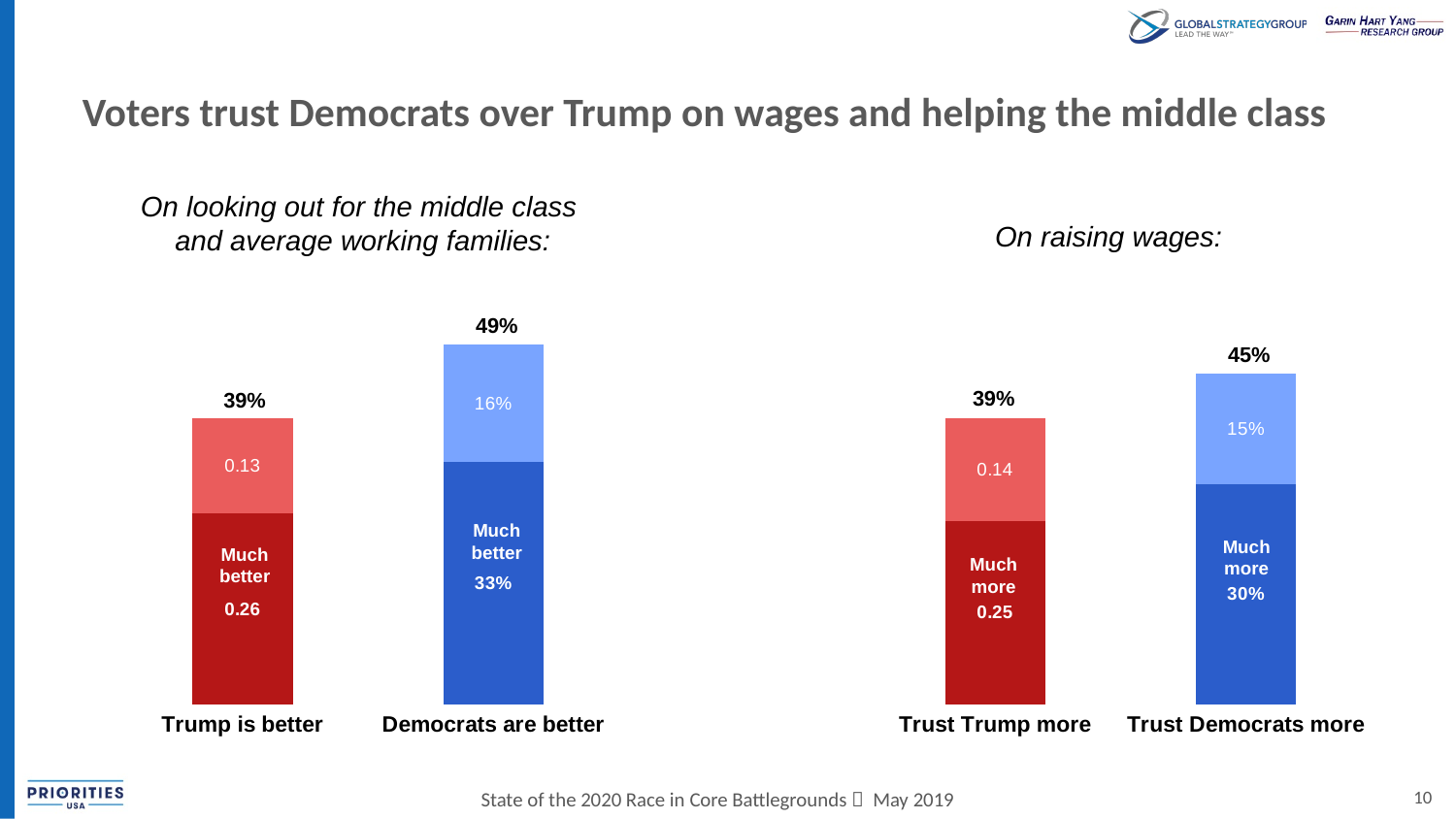
In the chart 'On raising wages', what is the total for 'Trust Democrats more'? 45% In the chart 'On raising wages', what is the difference between the totals for 'Trust Democrats more' and 'Trust Trump more'? 6 percentage points In the chart 'On looking out for the middle class and average working families', what is the difference between the totals for 'Democrats are better' and 'Trump is better'? 10 percentage points In the chart 'On looking out for the middle class and average working families', what is the 'Much better' value for 'Trump is better'? 0.26 In the chart 'On raising wages', what is the 'Much more' value for 'Trust Democrats more'? 30% In the chart 'On looking out for the middle class and average working families', what is the total for 'Trump is better'? 39% In the chart 'On looking out for the middle class and average working families', what is the total for 'Democrats are better'? 49% In the chart 'On looking out for the middle class and average working families', which bar has the higher total, 'Trump is better' or 'Democrats are better'? Democrats are better In the chart 'On looking out for the middle class and average working families', what is the 'Much better' value for 'Democrats are better'? 33% In the chart 'On raising wages', how many bars are shown? 2 What type of chart is used in the chart 'On raising wages'? Stacked bar chart In the chart 'On raising wages', what is the 'Much more' value for 'Trust Trump more'? 0.25